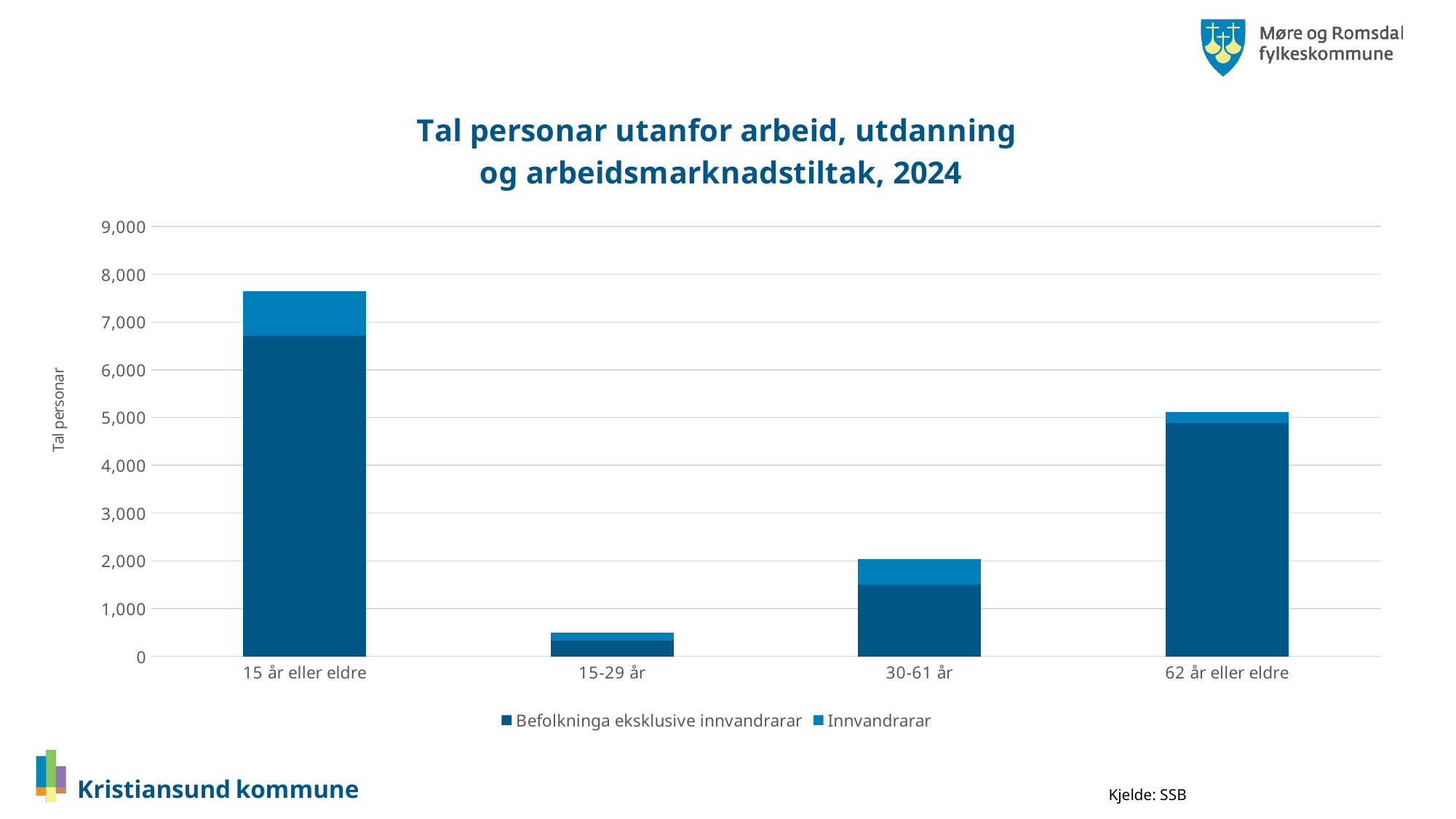
How many age categories are shown on the x axis? 4 How many series does the legend list? 2 Is the total value for 62 år eller eldre greater or less than 4,000? greater Is the total value for 15-29 år greater or less than 1,000? less Which age category has the tallest bar? 15 år eller eldre Which age category has the shortest bar? 15-29 år Is the total value for 30-61 år greater or less than 1,500? greater What are the two series named in the legend? Befolkninga eksklusive innvandrarar and Innvandrarar What is the title of the chart? Tal personar utanfor arbeid, utdanning og arbeidsmarknadstiltak, 2024 What kind of chart is shown on the slide? bar chart Which bar is taller, 30-61 år or 62 år eller eldre? 62 år eller eldre